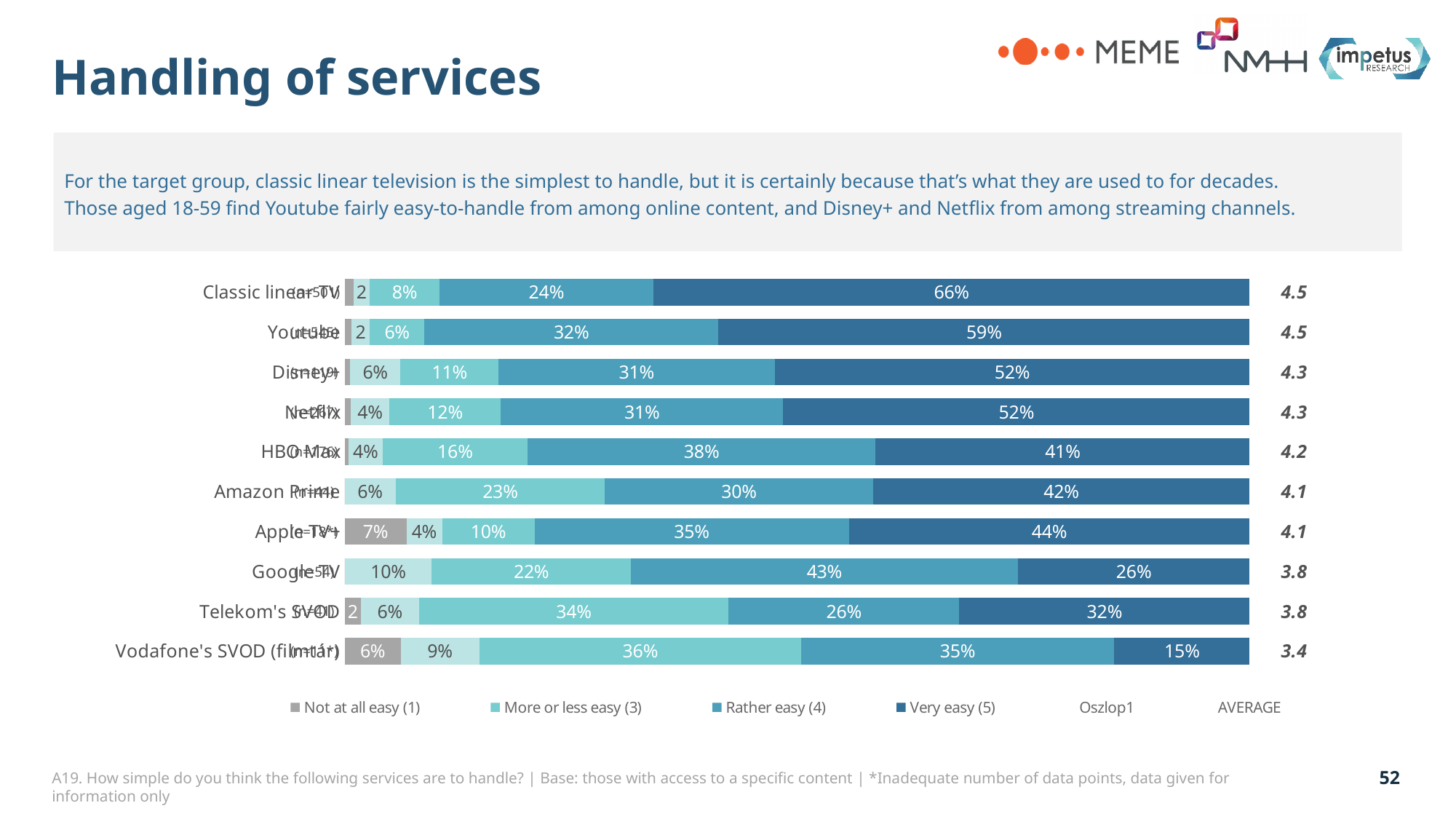
Which service has the lowest share of Very easy (5) ratings? Vodafone's SVOD (filmtár) Which service has the highest share of Very easy (5) ratings? Classic linear TV What is the difference between the Very easy (5) shares for Youtube and Disney+? 7 percentage points What type of chart is shown on the slide? Stacked bar chart How many services are listed in the chart? 10 What percentage of respondents rated Telekom's SVOD as More or less easy (3)? 34% Which has a larger Rather easy (4) share, Google TV or HBO Max? Google TV Which service has the lowest average score? Vodafone's SVOD (filmtár) What percentage of respondents rated Amazon Prime as Rather easy (4)? 30% What is the average score shown for Netflix? 4.3 What percentage of respondents rated Classic linear TV as Very easy (5) to handle? 66% What is the average score shown for Google TV? 3.8